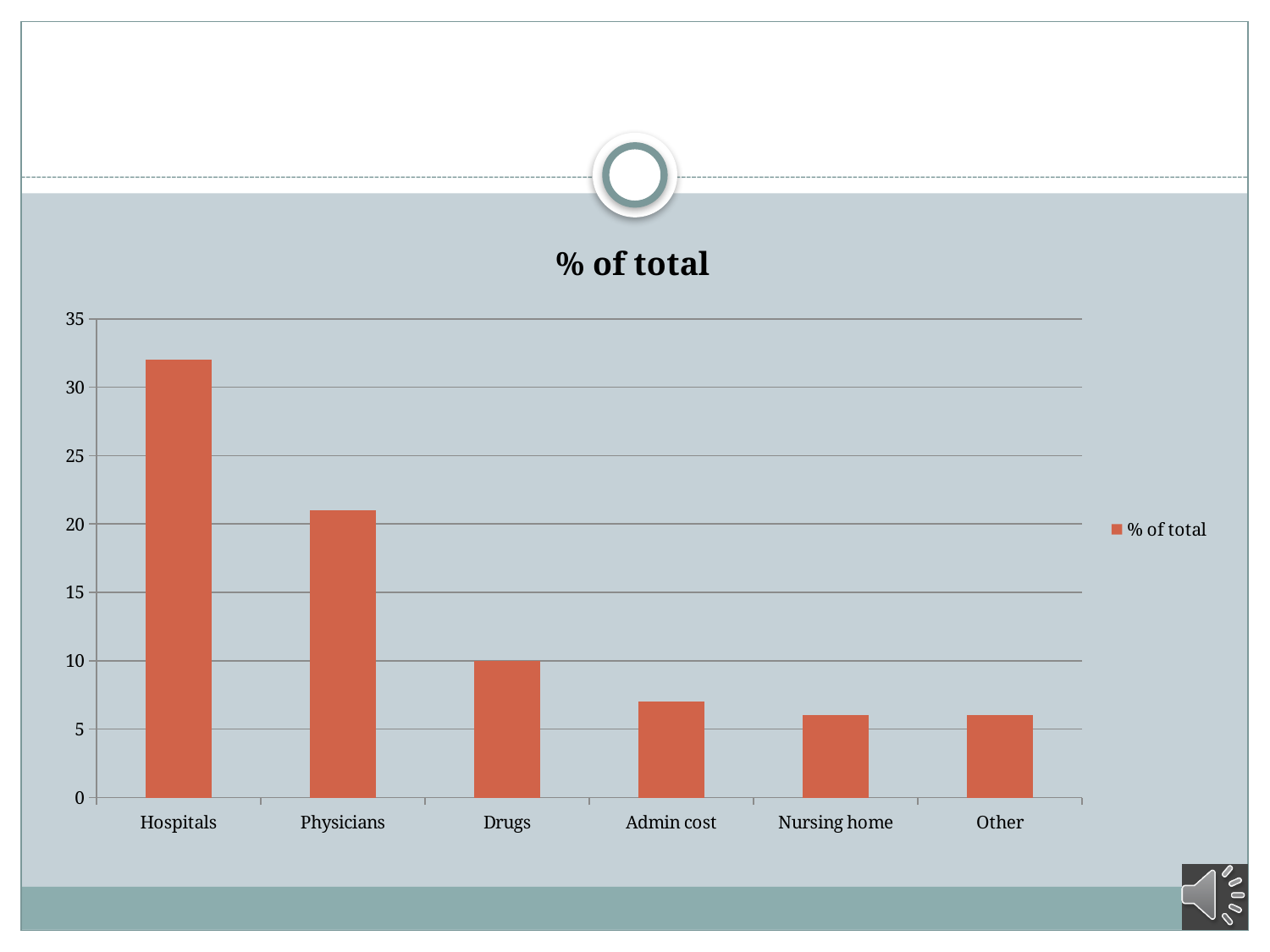
Which category has the highest value? Hospitals Is the value for Physicians greater or less than 20? greater Is the value for Hospitals greater or less than 30? greater How many categories are shown on the x axis of the chart? 6 How many series does the legend list? 1 Which is larger, the value for Physicians or the value for Drugs? Physicians Do the values generally rise or fall from left to right along the x axis? fall What is the title of the chart? % of total Is the value for Nursing home greater or less than 10? less What type of chart is shown on the slide? bar chart What is the value for Drugs? 10